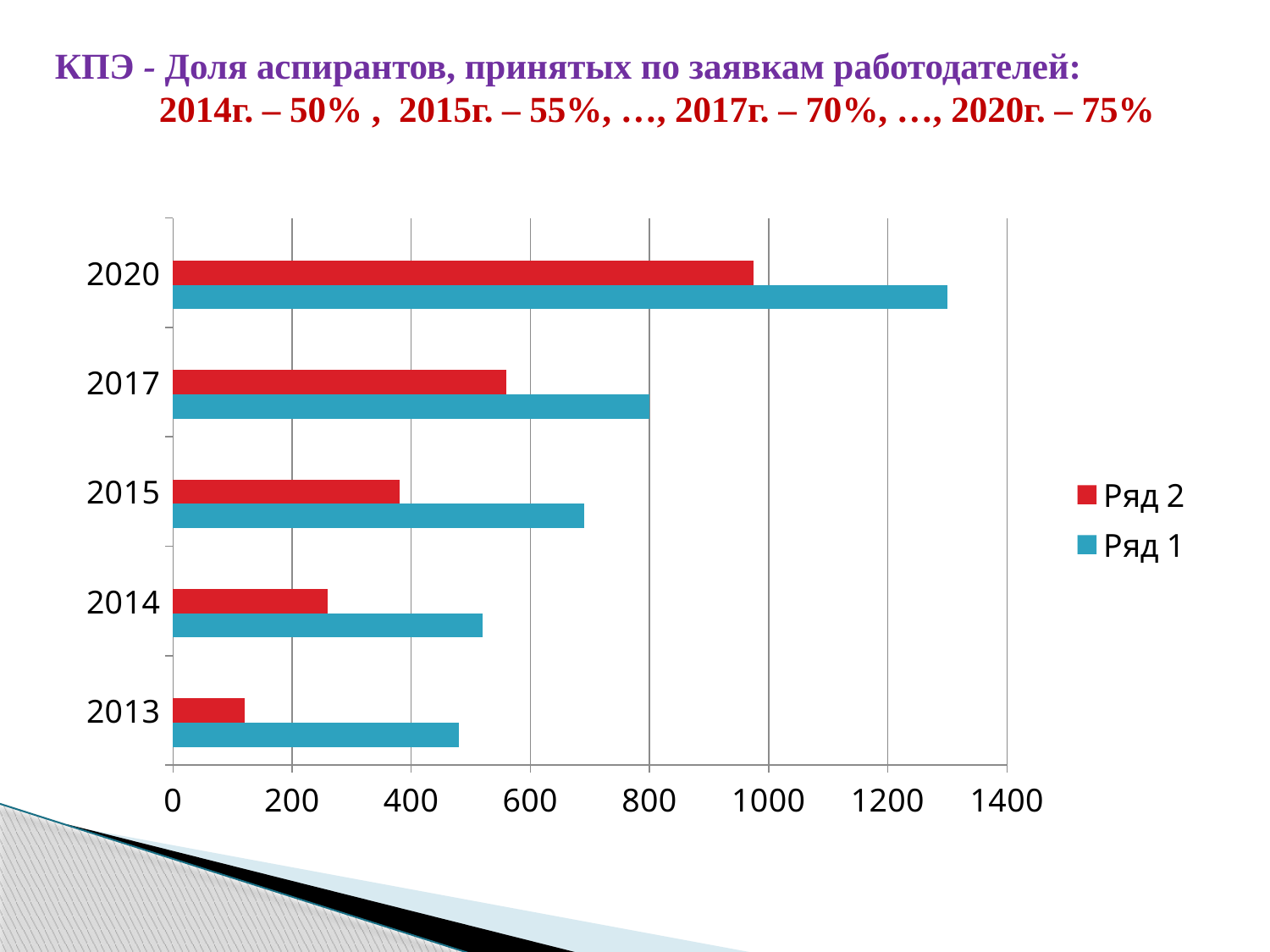
What are the two entries listed in the legend? Ряд 2 and Ряд 1 For 2020, which series has the larger value, Ряд 1 or Ряд 2? Ряд 1 Which year has the lowest value for Ряд 2? 2013 Is the value for Ряд 2 in 2013 greater or less than 200? less Is the value for Ряд 1 in 2014 greater or less than 400? greater How many series does the legend list? 2 Is the value for Ряд 1 in 2020 greater or less than 1200? greater How many year categories are plotted on the chart? 5 Do the values for Ряд 1 rise or fall from 2013 to 2020? rise What kind of chart is shown on the slide? bar chart Which year has the highest value for Ряд 1? 2020